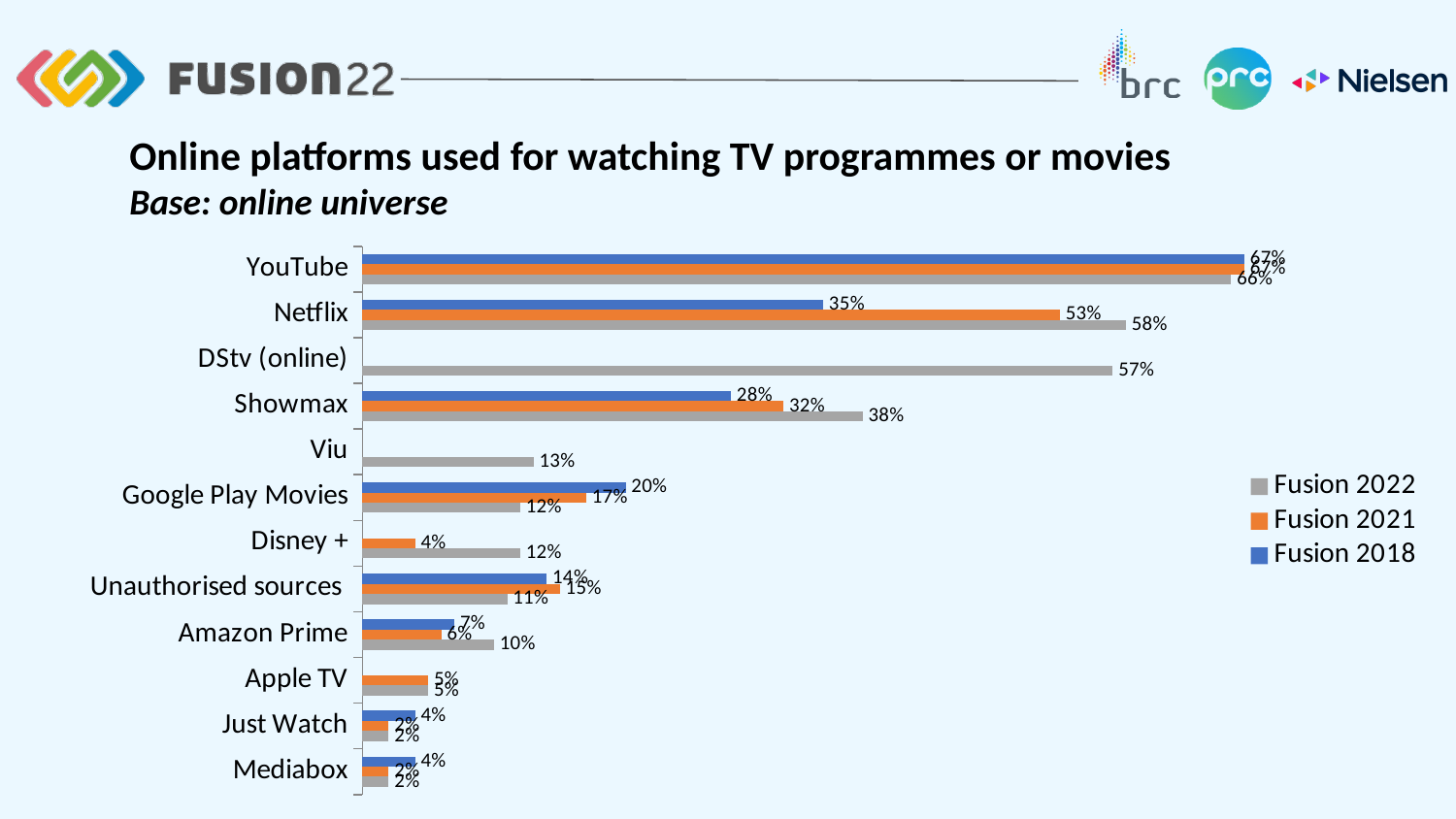
What is the Fusion 2022 value for Netflix? 58% What is the Fusion 2022 value for Showmax? 38% For Showmax, which is larger: the Fusion 2021 value or the Fusion 2018 value? Fusion 2021 What is the Fusion 2022 value for Amazon Prime? 10% What is the difference between the Fusion 2022 and Fusion 2018 values for Netflix? 23 percentage points How many platforms are listed on the chart? 12 How many series does the legend list? 3 What kind of chart is shown on the slide? Bar chart What is the Fusion 2022 value for DStv (online)? 57% Which platform has the highest Fusion 2022 value? YouTube What is the Fusion 2018 value for Netflix? 35% What is the Fusion 2018 value for Google Play Movies? 20%